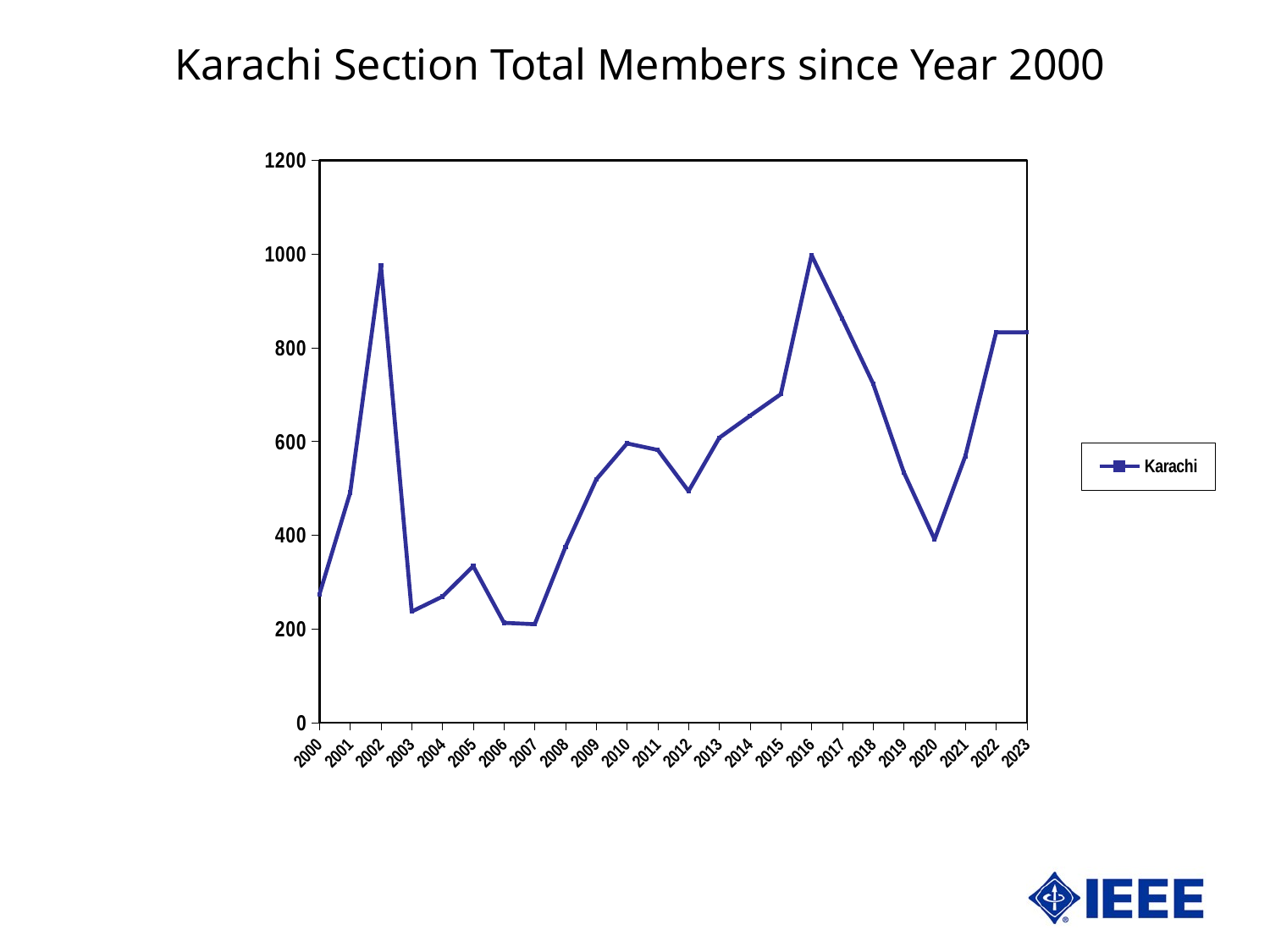
Is the value for 2002 greater or less than 800? greater Is the value for 2016 greater or less than 800? greater Which year has the larger value, 2002 or 2003? 2002 Is the value for 2020 greater or less than 600? less Do the values rise or fall from 2007 to 2010? rise Which year has the larger value, 2016 or 2020? 2016 What kind of chart is shown on the slide? line chart How many years are plotted along the x axis? 24 Do the values rise or fall from 2016 to 2020? fall What is the name of the series shown in the legend? Karachi How many series does the legend list? 1